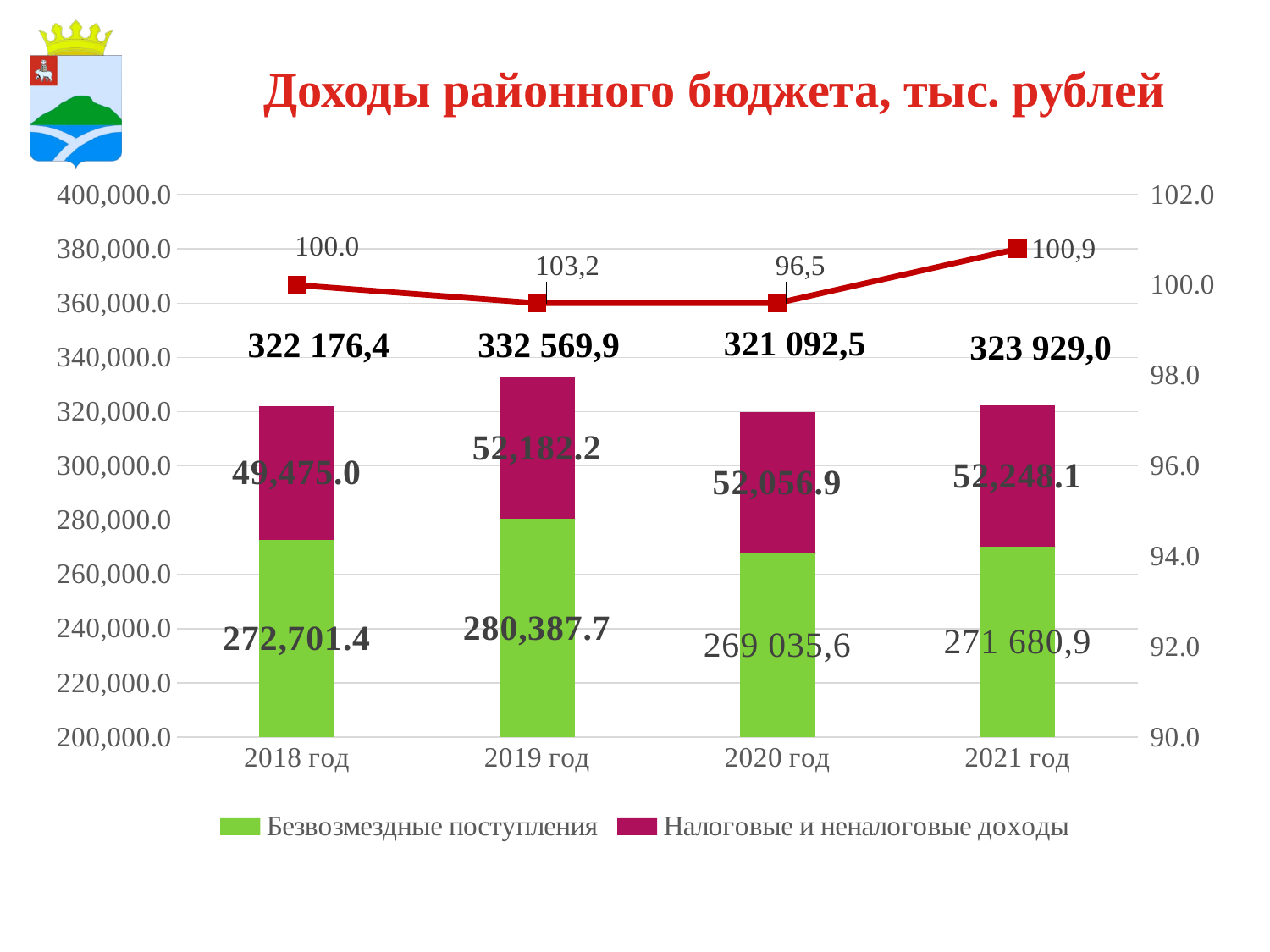
Which year has the highest total income? 2019 год What is the total income shown above the bar for 2020 год? 321 092,5 How many years are shown on the x axis? 4 Which year has the lowest value of Налоговые и неналоговые доходы? 2018 год By how much did Безвозмездные поступления increase from 2018 год to 2019 год? 7,686.3 What is the value of Налоговые и неналоговые доходы for 2018 год? 49,475.0 How many series does the legend list? 2 What is the value of Безвозмездные поступления for 2019 год? 280,387.7 Which year has the larger value of Налоговые и неналоговые доходы, 2020 год or 2021 год? 2021 год What value does the red line show for 2020 год? 96,5 What is the difference between the total income for 2019 год and 2018 год? 10 393,5 What kind of chart is used to show the income components? Stacked bar chart